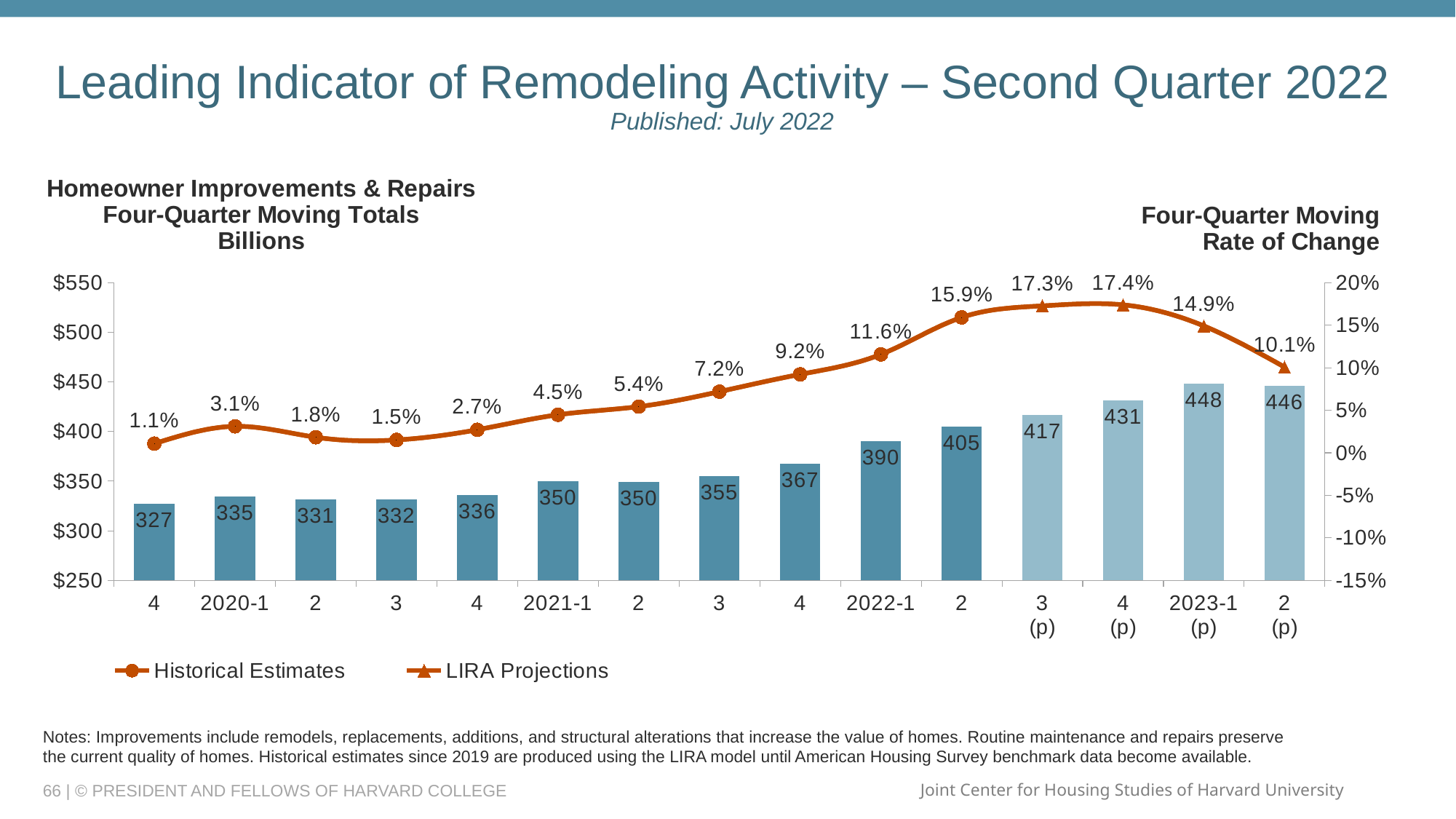
How many quarters are plotted along the x axis? 15 Which quarter has the highest four-quarter moving total bar? 2023-1 (p) What is the four-quarter moving rate of change for 2021-1? 4.5% What is the projected four-quarter moving rate of change for quarter 3 (p) of 2022? 17.3% What kind of chart is shown on the slide? Combined bar and line chart Which is larger, the four-quarter moving total for 2023-1 (p) or for 2 (p) of 2023? 2023-1 (p) What is the highest four-quarter moving rate of change shown on the line? 17.4% Do the four-quarter moving total bars rise or fall from 2021-1 to 2023-1 (p)? Rise What is the lowest four-quarter moving total shown on the chart? 327 What is the difference between the four-quarter moving totals for 2022-2 and 2022-1? 15 How many series does the legend list? 2 What is the four-quarter moving total (in billions) for 2022-1? 390